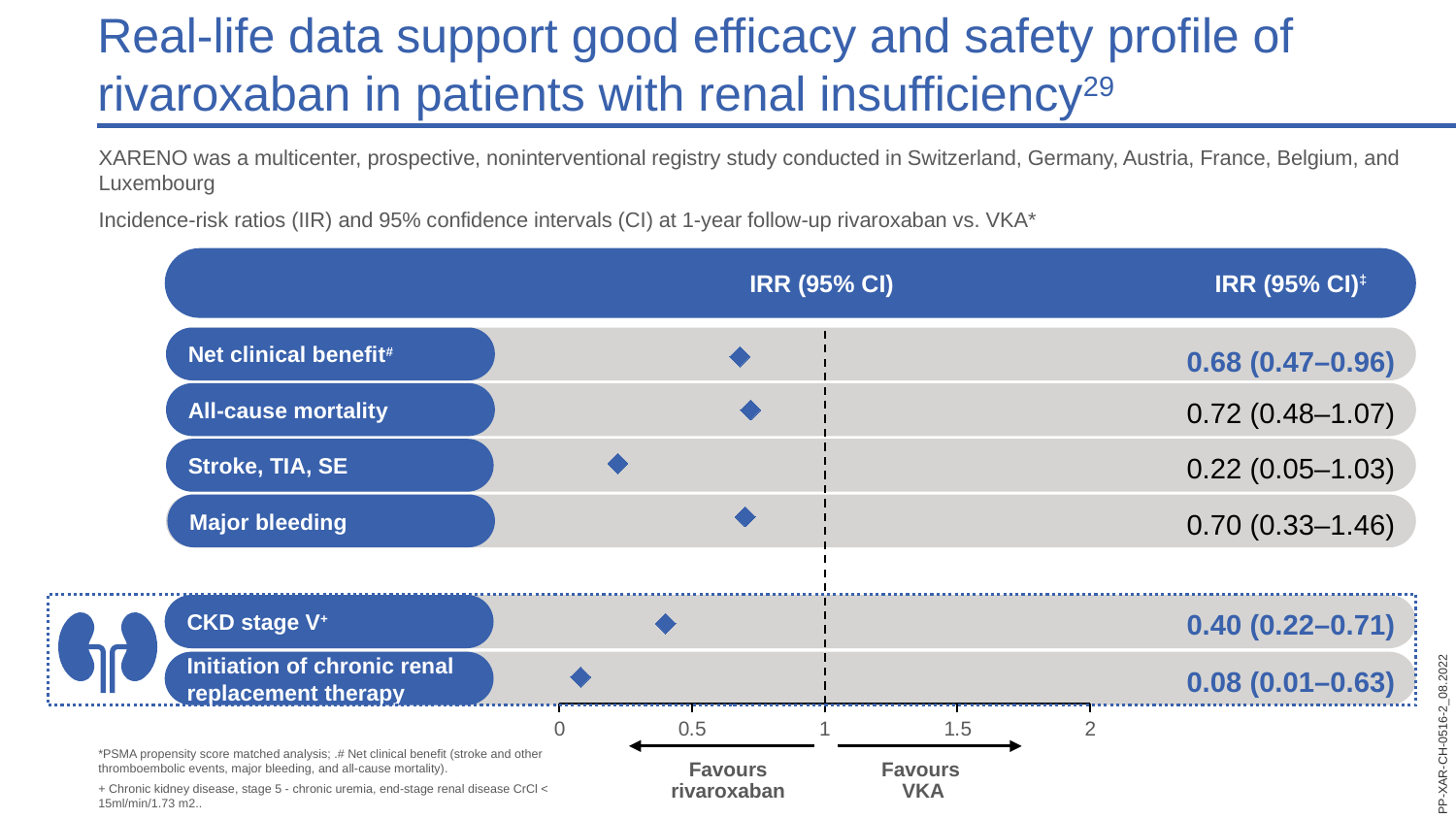
What is the IRR (95% CI) for Initiation of chronic renal replacement therapy? 0.08 (0.01–0.63) Which outcome has the lowest IRR point estimate? Initiation of chronic renal replacement therapy What is the IRR (95% CI) for All-cause mortality? 0.72 (0.48–1.07) Which side of the x axis is labelled 'Favours rivaroxaban'? The left side (values below 1) How many outcomes are plotted in the chart? 6 What is the difference between the IRR point estimates for All-cause mortality and Net clinical benefit? 0.04 What is the IRR (95% CI) for CKD stage V? 0.40 (0.22–0.71) What is the IRR (95% CI) for Major bleeding? 0.70 (0.33–1.46) What is the IRR (95% CI) for Stroke, TIA, SE? 0.22 (0.05–1.03) Which has a larger IRR point estimate, Major bleeding or CKD stage V? Major bleeding What is the IRR (95% CI) for Net clinical benefit? 0.68 (0.47–0.96) Which outcome has the highest IRR point estimate? All-cause mortality